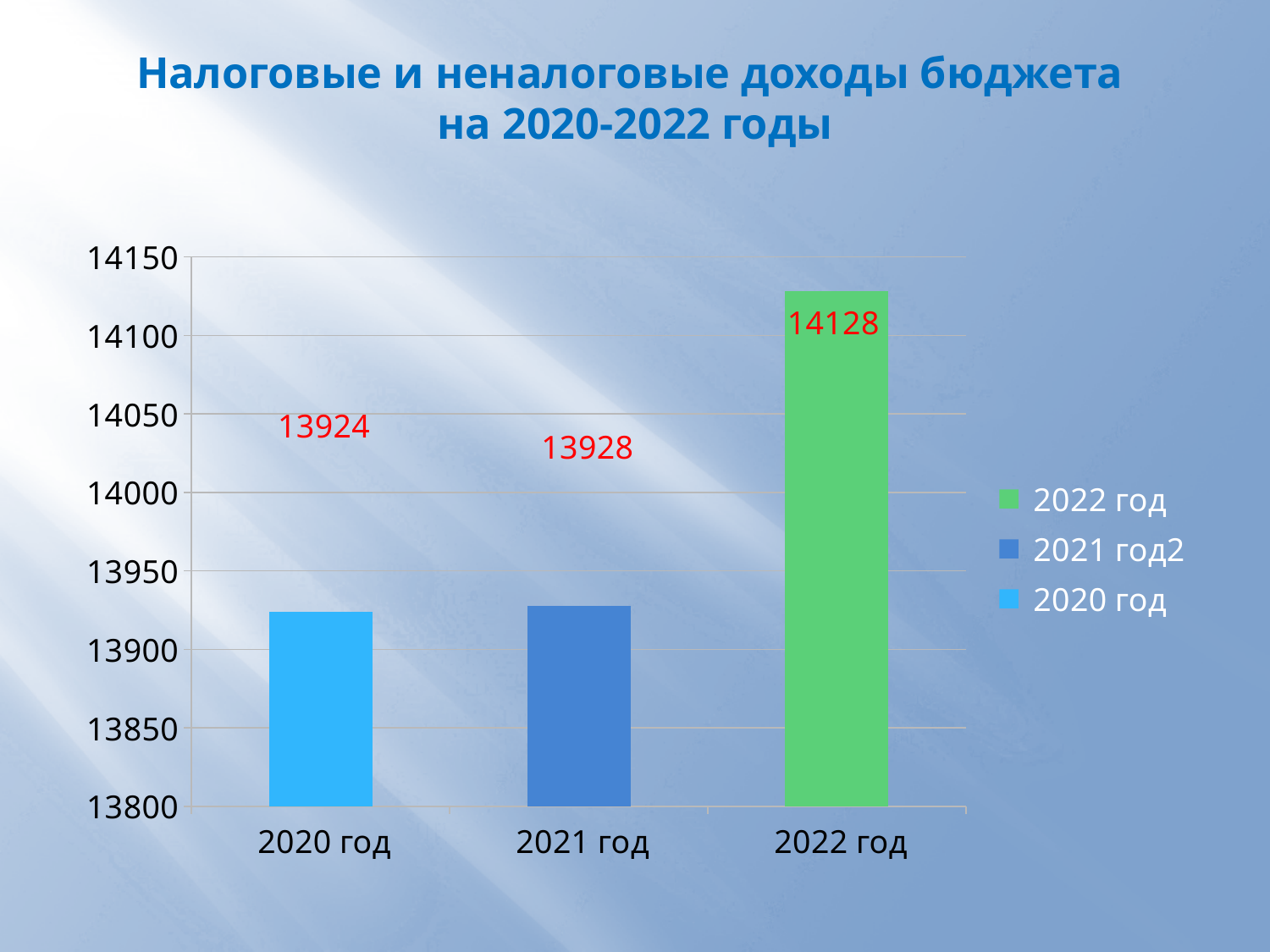
Is the value for 2020 год greater or less than 13950? less What is the value for 2020 год? 13924 How many bars are shown in the chart? 3 Which year has the highest value? 2022 год What is the value for 2022 год? 14128 Is the value for 2022 год greater or less than 14100? greater What is the difference between the values for 2021 год and 2020 год? 4 Which is larger, the value for 2022 год or the value for 2020 год? 2022 год What kind of chart is shown on the slide? bar chart How many entries does the legend list? 3 What is the value for 2021 год? 13928 What is the difference between the values for 2022 год and 2021 год? 200